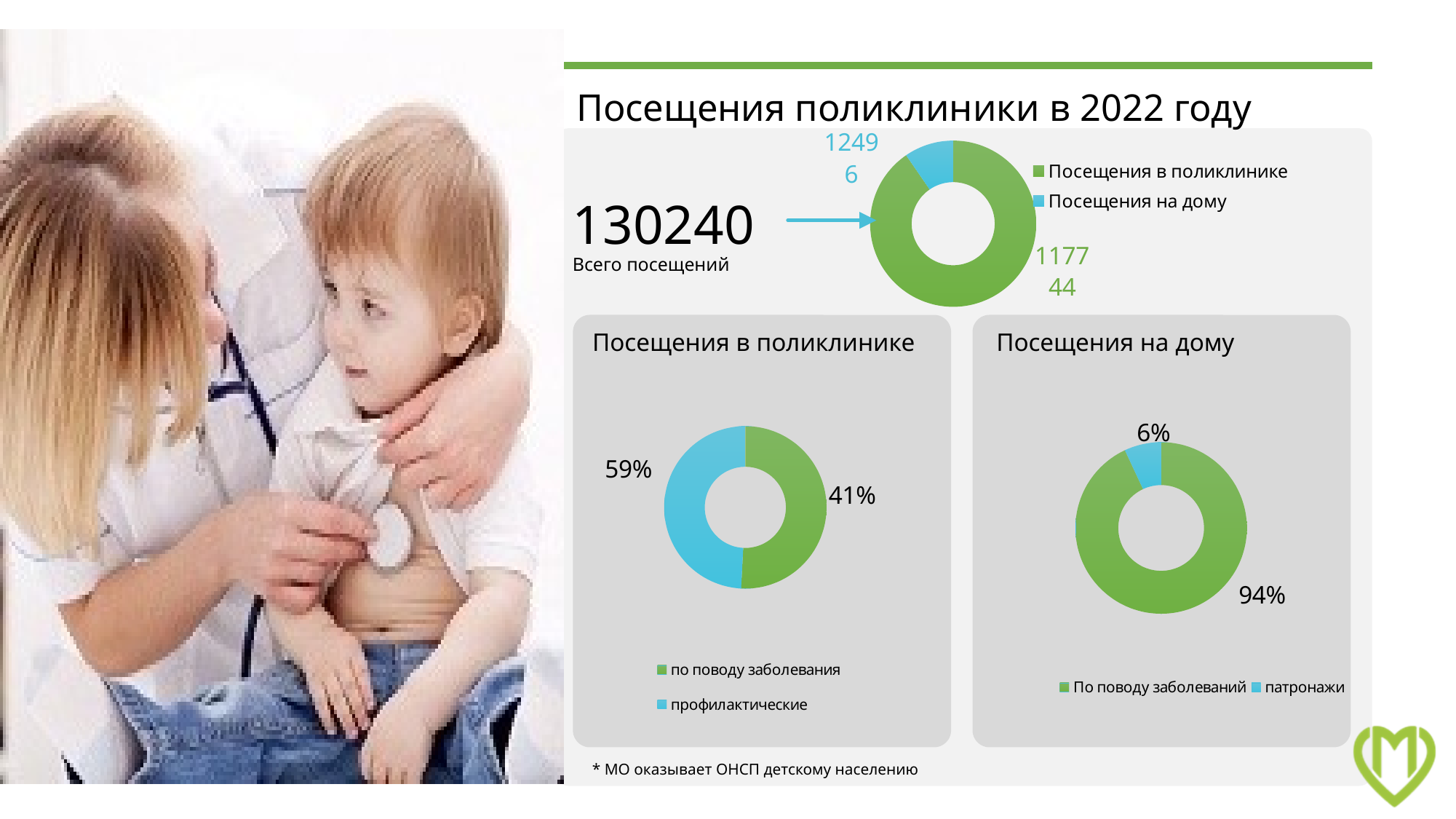
In the chart 'Посещения на дому', what share is 'патронажи'? 6% In the top chart, what is the value for 'Посещения в поликлинике'? 117744 In the chart 'Посещения на дому', which colour represents 'патронажи'? Blue What kind of chart is used in the top chart next to the total of 130240? Donut (pie) chart In the top chart, what is the value for 'Посещения на дому'? 12496 In the chart 'Посещения на дому', what is the difference between the shares of 'По поводу заболеваний' and 'патронажи'? 88% In the chart 'Посещения в поликлинике', what share is 'по поводу заболевания'? 41% In the chart 'Посещения в поликлинике', what share is 'профилактические'? 59% In the chart 'Посещения в поликлинике', which category has the largest share? профилактические What is the total number of visits ('Всего посещений') shown on the slide? 130240 In the top chart, which category is larger: 'Посещения в поликлинике' or 'Посещения на дому'? Посещения в поликлинике How many categories does the legend of the top chart list? 2